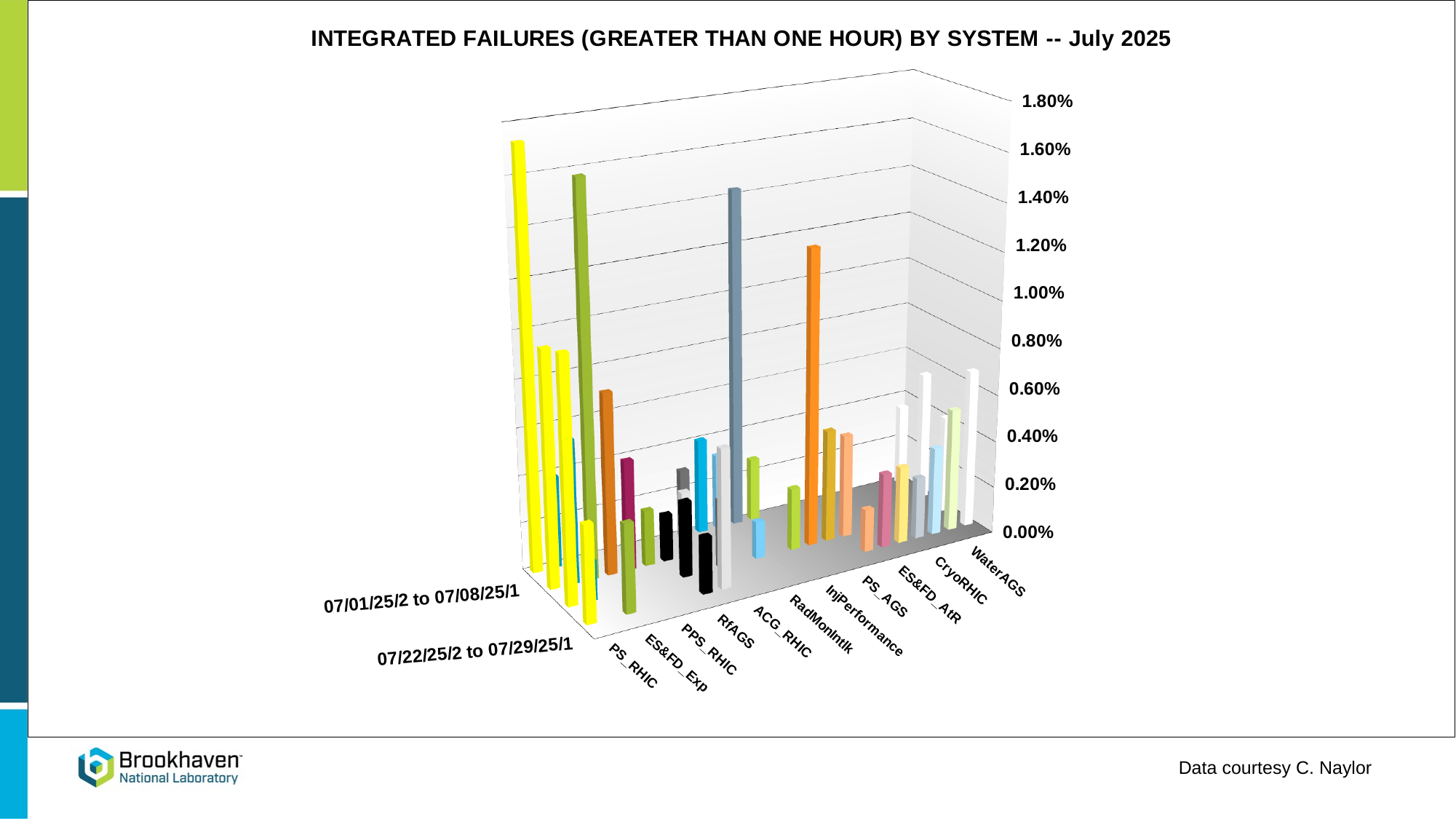
Is the tallest bar for PS_AGS greater or less than 0.80%? less Which system has the tallest bar in the chart? PS_RHIC Is the tallest bar for RfAGS greater or less than 0.80%? less Which system has a taller tallest bar, PS_RHIC or RfAGS? PS_RHIC What is the highest value shown on the vertical axis of the chart? 1.80% How many systems (categories) are listed along the horizontal axis of the chart? 11 What kind of chart is shown on the slide? bar chart Is the tallest bar for PS_RHIC greater or less than 1.00%? greater What is the title of the chart? INTEGRATED FAILURES (GREATER THAN ONE HOUR) BY SYSTEM -- July 2025